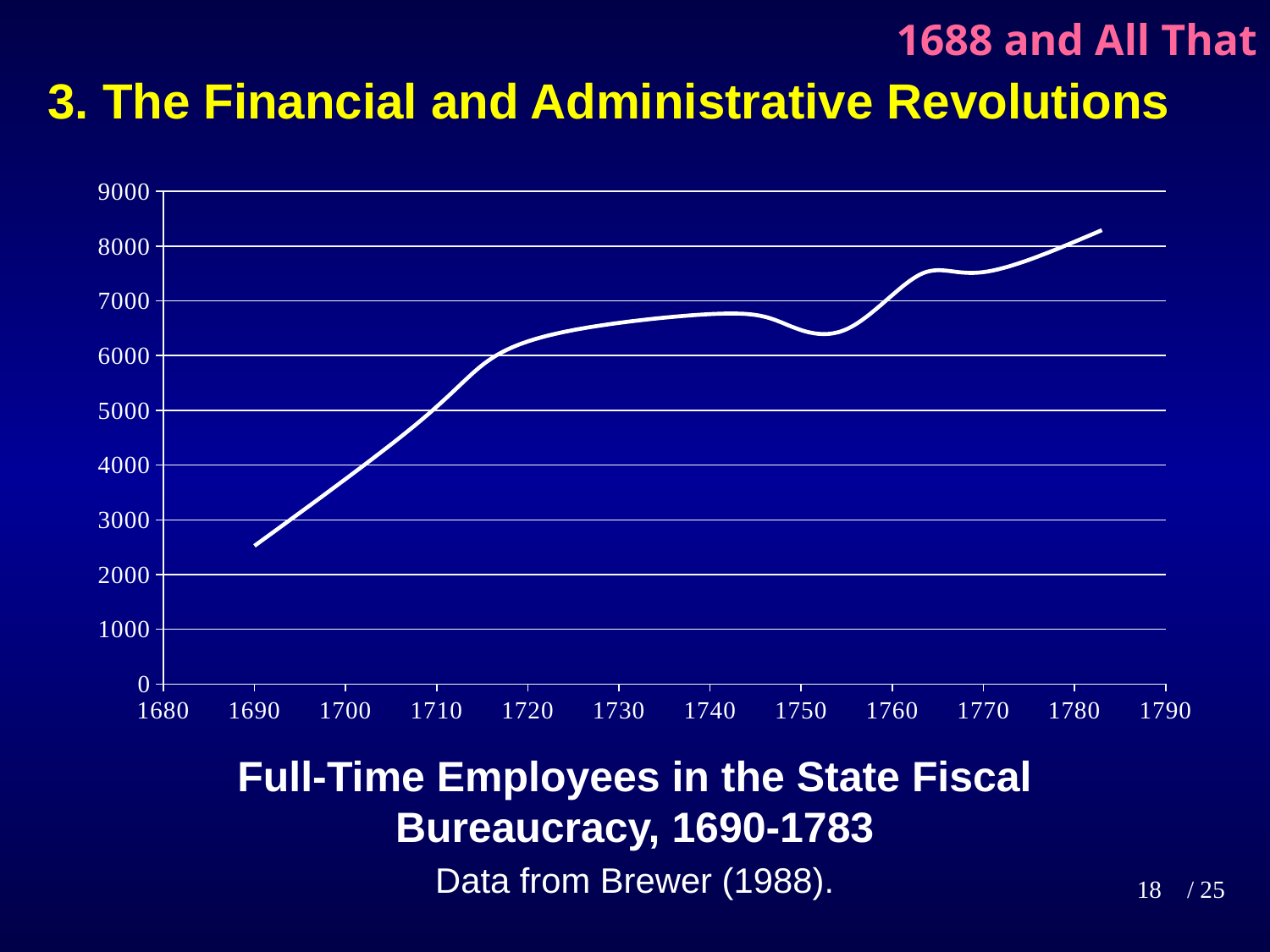
Is the value for 1690 greater or less than 3000? less Is the value for 1730 greater or less than 6000? greater Overall, do the values rise or fall from 1690 to 1783? rise What is the title of the chart? Full-Time Employees in the State Fiscal Bureaucracy, 1690-1783 Is the value for 1770 greater or less than 7000? greater What kind of chart is shown on the slide? line chart According to the slide, what is the source of the chart's data? Brewer (1988) Which is larger, the value for 1750 or the value for 1770? 1770 In which year shown on the x axis is the value lowest? 1690